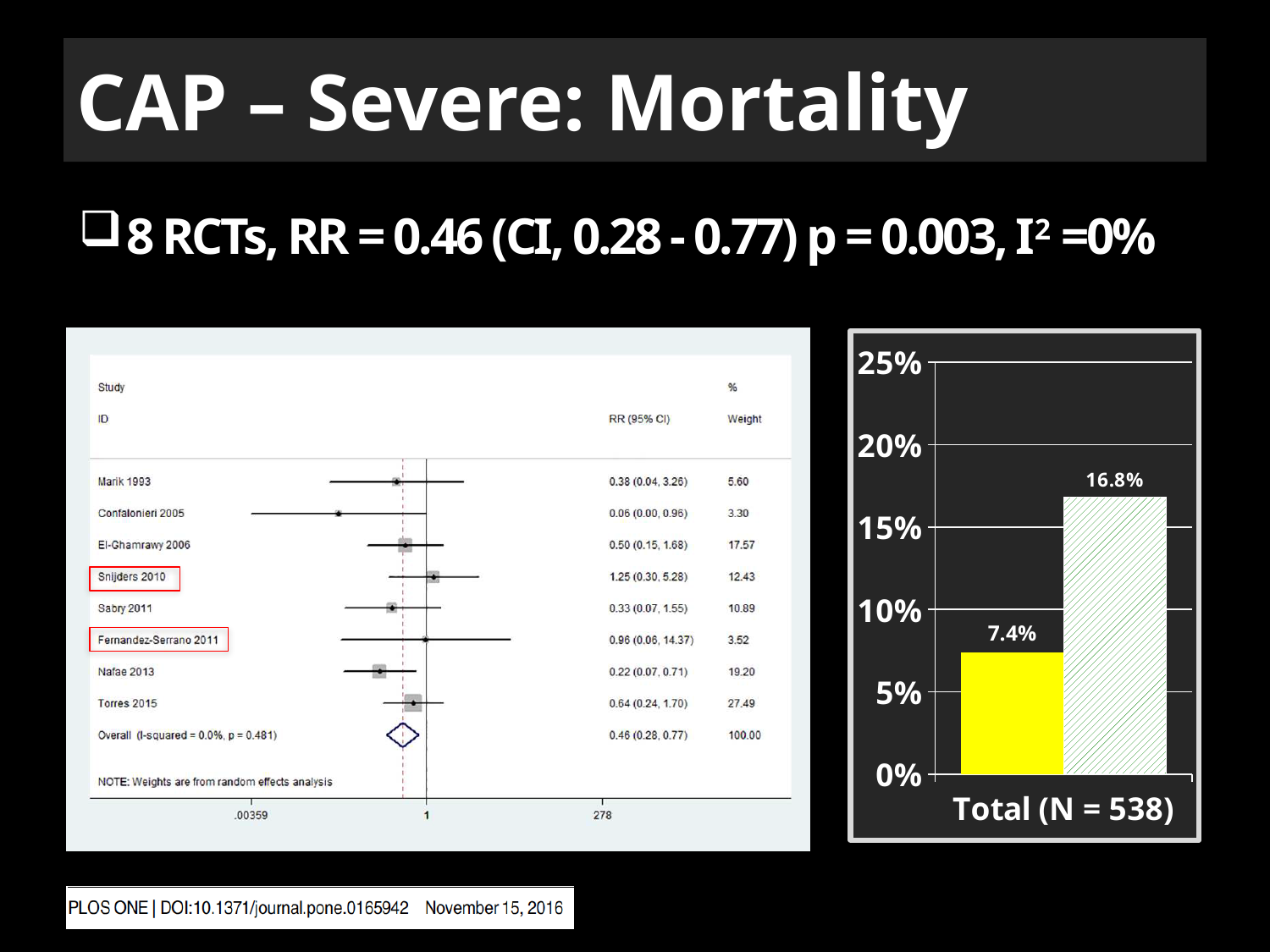
On the bar chart on the right, what value is shown for the green hatched bar? 16.8% On the bar chart on the right, what value is shown for the yellow bar? 7.4% On the forest plot on the left, which study has the highest % weight? Torres 2015 On the forest plot on the left, what is the overall RR (95% CI)? 0.46 (0.28, 0.77) On the bar chart on the right, which bar is taller, the yellow bar or the hatched bar? the hatched bar What kind of chart is shown on the right side of the slide? bar chart On the forest plot on the left, what is the RR (95% CI) for Torres 2015? 0.64 (0.24, 1.70) On the bar chart on the right, what is the category label on the x axis? Total (N = 538) On the bar chart on the right, what is the difference between the hatched bar and the yellow bar? 9.4% On the bar chart on the right, is the value of the yellow bar greater or less than 10%? less On the forest plot on the left, which study has the lowest % weight? Confalonieri 2005 On the bar chart on the right, how many bars are plotted? 2